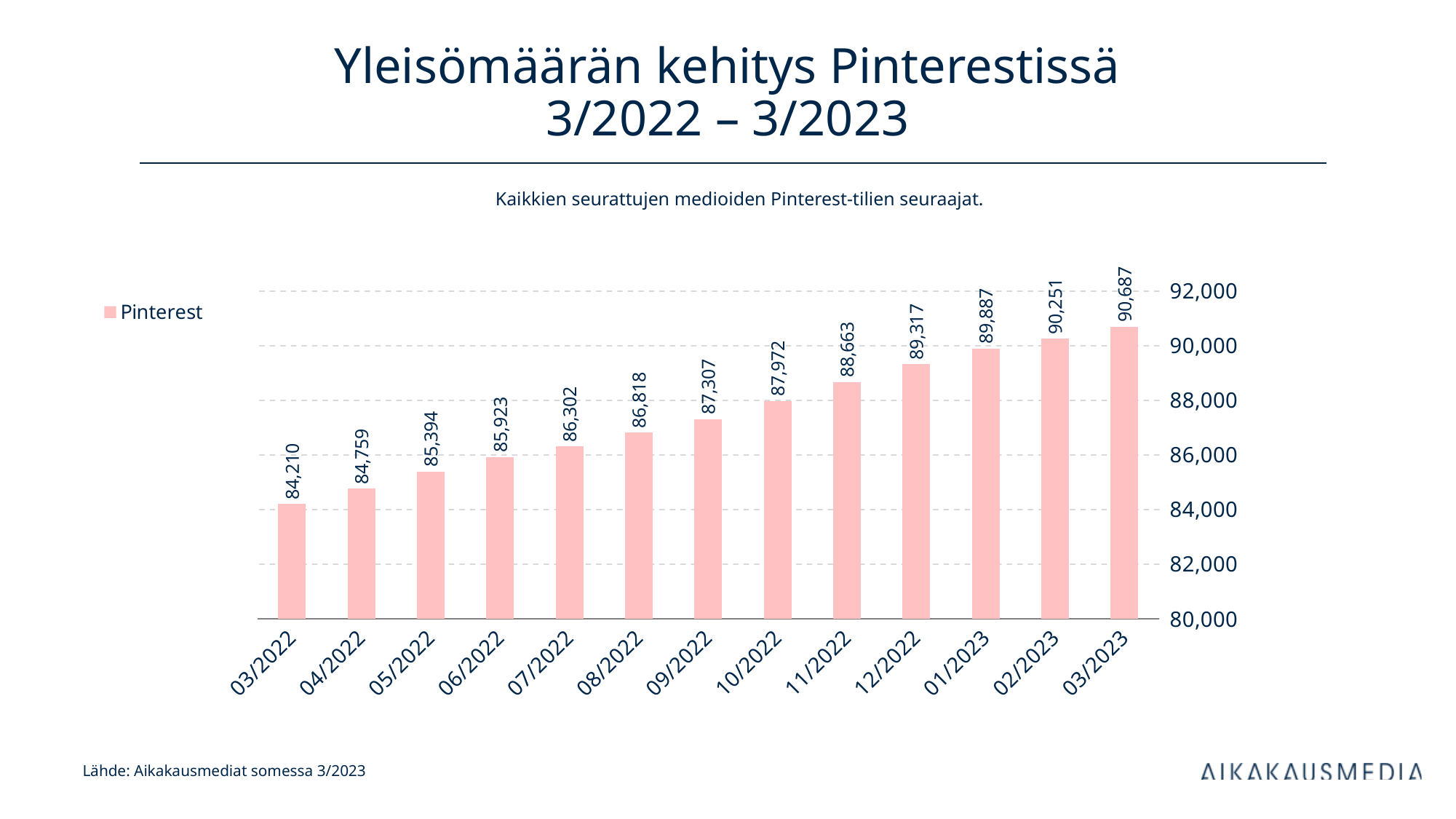
Is the value for 01/2023 greater or less than 90,000? less Which month has the highest value? 03/2023 How many months are shown on the x axis? 13 What is the value for 10/2022? 87,972 What is the difference between the values for 03/2023 and 03/2022? 6,477 What is the difference between the values for 12/2022 and 11/2022? 654 Which is larger, the value for 07/2022 or the value for 09/2022? 09/2022 What kind of chart is shown on the slide? bar chart Which month has the lowest value? 03/2022 What is the value for 03/2023? 90,687 Do the values rise or fall from 03/2022 to 03/2023? rise What is the value for 03/2022? 84,210